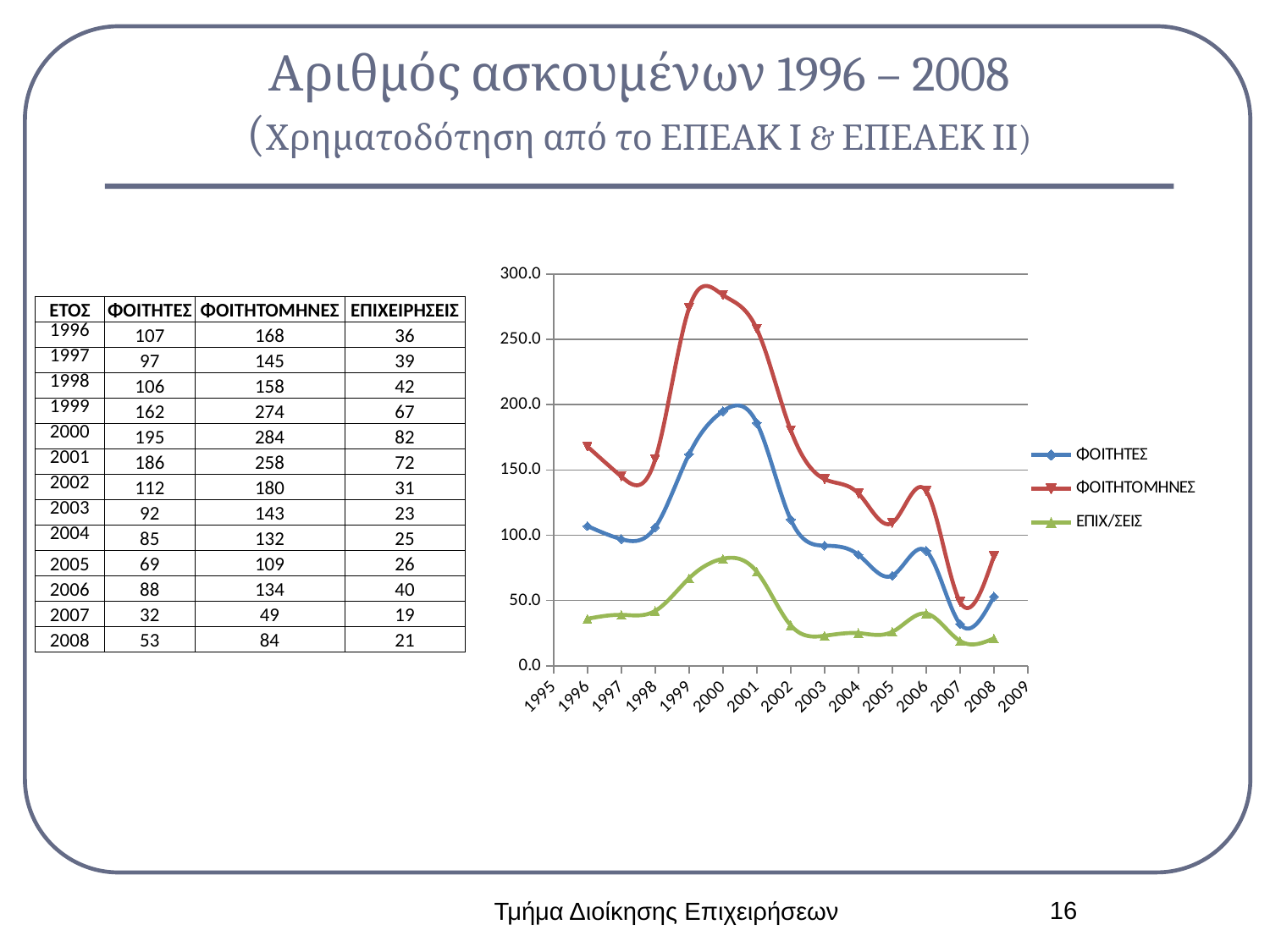
What is the difference between the ΦΟΙΤΗΤΟΜΗΝΕΣ value in 2000 and in 2008? 200 How many years are plotted for each series in the chart? 13 In which year does the ΦΟΙΤΗΤΟΜΗΝΕΣ series reach its highest value? 2000 What is the value of ΕΠΙΧΕΙΡΗΣΕΙΣ in 1999? 67 How many series does the chart legend list? 3 What kind of chart is shown on the slide? Line chart Does the ΦΟΙΤΗΤΕΣ series rise or fall from 2000 to 2005? Fall Is the value for ΦΟΙΤΗΤΟΜΗΝΕΣ in 2000 greater or less than 250.0? greater Which is larger for ΦΟΙΤΗΤΕΣ: the value in 1999 or the value in 2003? 1999 Is the value for ΦΟΙΤΗΤΕΣ in 2007 greater or less than 50.0? less What is the value of ΦΟΙΤΗΤΕΣ in 2000? 195 In which year does the ΦΟΙΤΗΤΕΣ series reach its lowest value? 2007